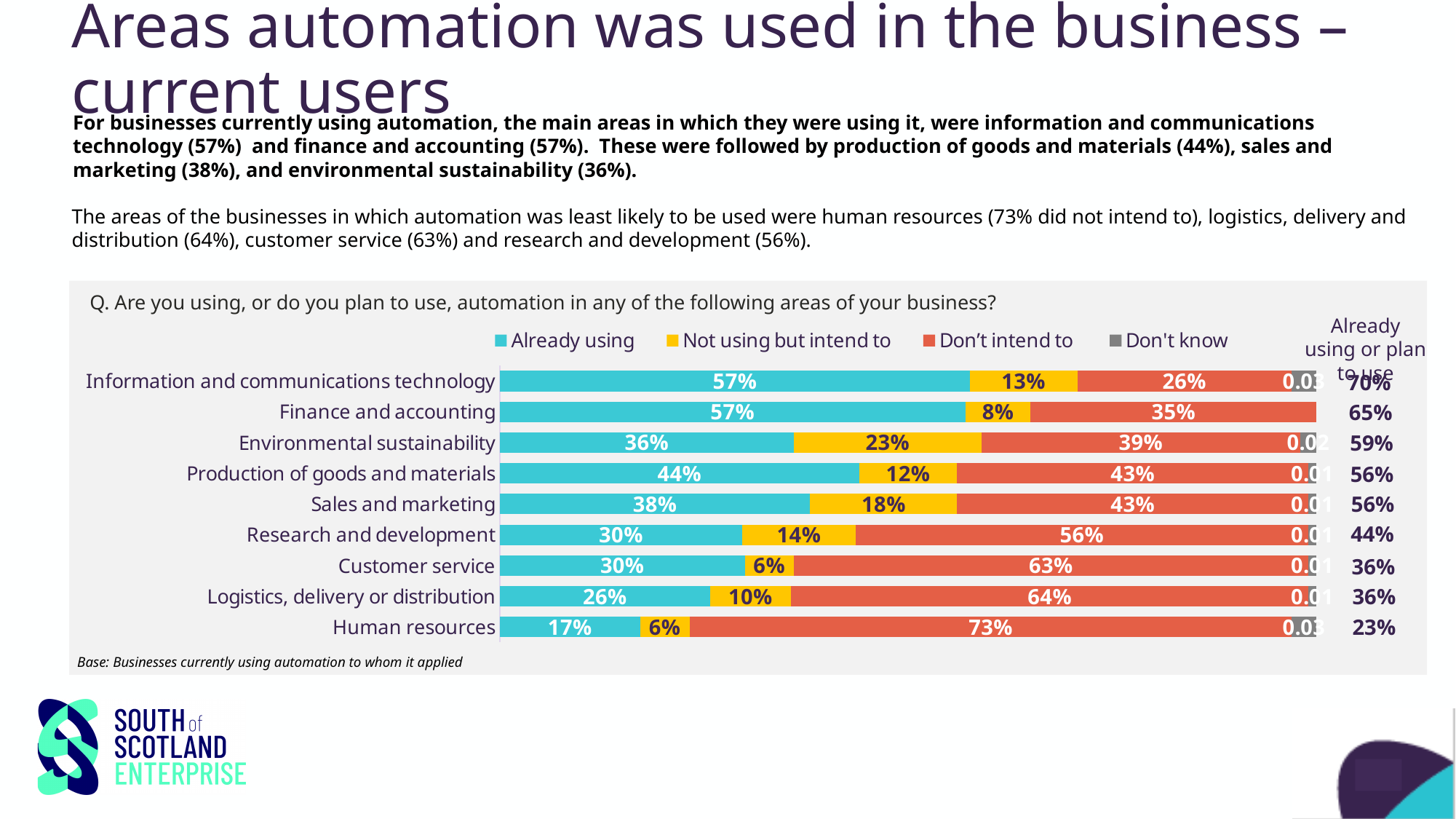
What is the difference between the 'Already using' values for Production of goods and materials and Sales and marketing? 6% What is the 'Not using but intend to' value for Environmental sustainability? 23% What kind of chart is shown on the slide? Stacked bar chart Which is larger: the 'Not using but intend to' value for Sales and marketing or for Research and development? Sales and marketing Which business area has the lowest 'Already using' value? Human resources Which legend entry is shown in orange/red? Don't intend to How many business areas (categories) are shown in the chart? 9 What percentage of businesses are already using automation in Finance and accounting? 57% What is the 'Don't intend to' value for Logistics, delivery or distribution? 64% What is the 'Already using or plan to use' figure shown for Information and communications technology? 70% Which business area has the highest 'Don't intend to' value? Human resources How many series does the chart legend list? 4